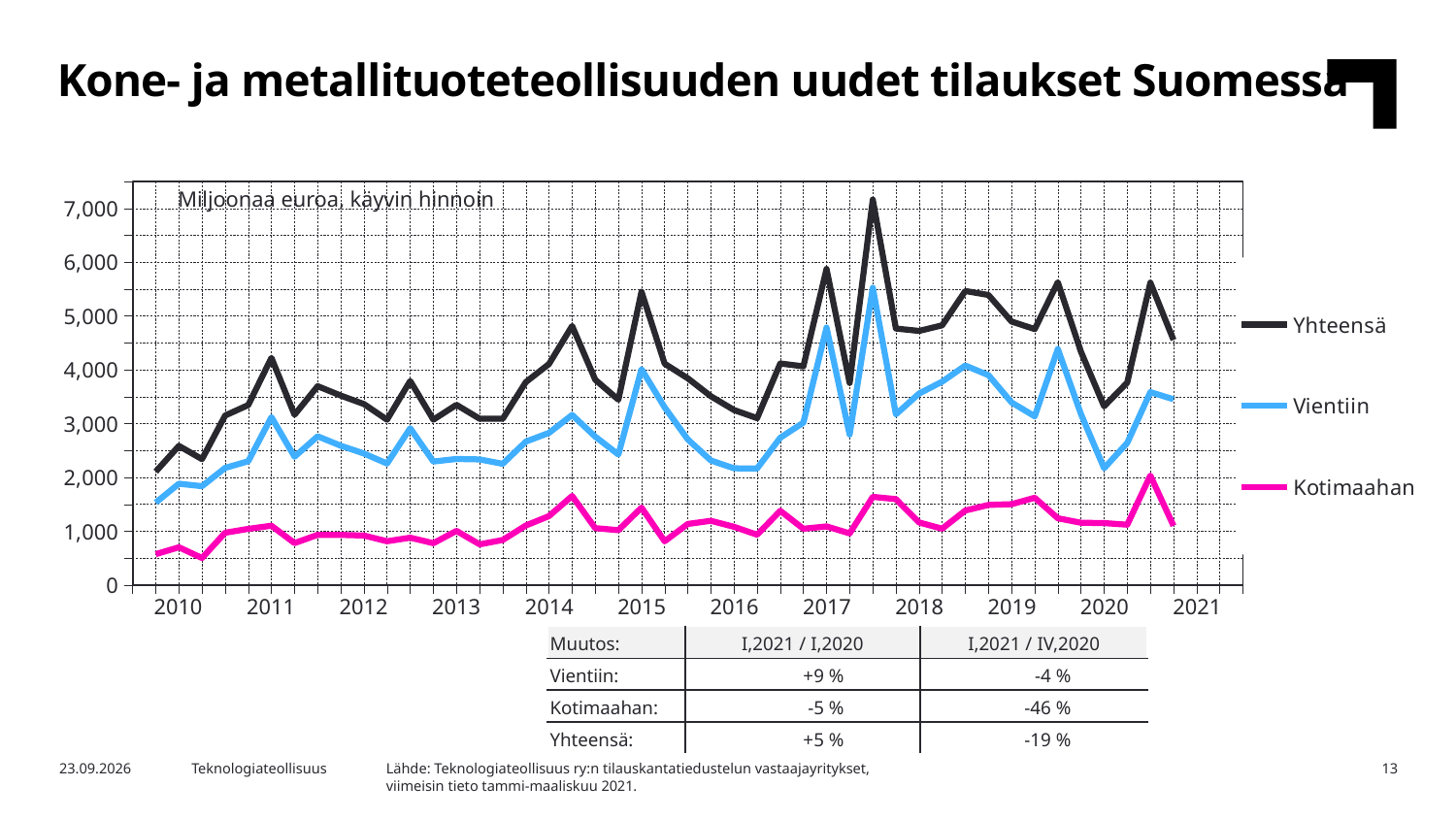
Which series is larger in 2019, Vientiin or Kotimaahan? Vientiin What unit is stated at the top of the chart area? Miljoonaa euroa, käyvin hinnoin Is the peak value of the Yhteensä series in 2017 greater or less than 6,000? greater What kind of chart is shown on the slide? line chart Which series has the lowest values throughout the chart? Kotimaahan Does the Yhteensä series rise or fall from the start of 2010 to the start of 2011? rise Which series has the highest values throughout the chart? Yhteensä Which series is shown in black in the legend? Yhteensä How many series does the legend list? 3 How many year labels are shown on the x axis? 12 Is the value for Kotimaahan at the start of 2010 greater or less than 1,000? less Is the peak value of the Vientiin series in 2017 greater or less than 5,000? greater